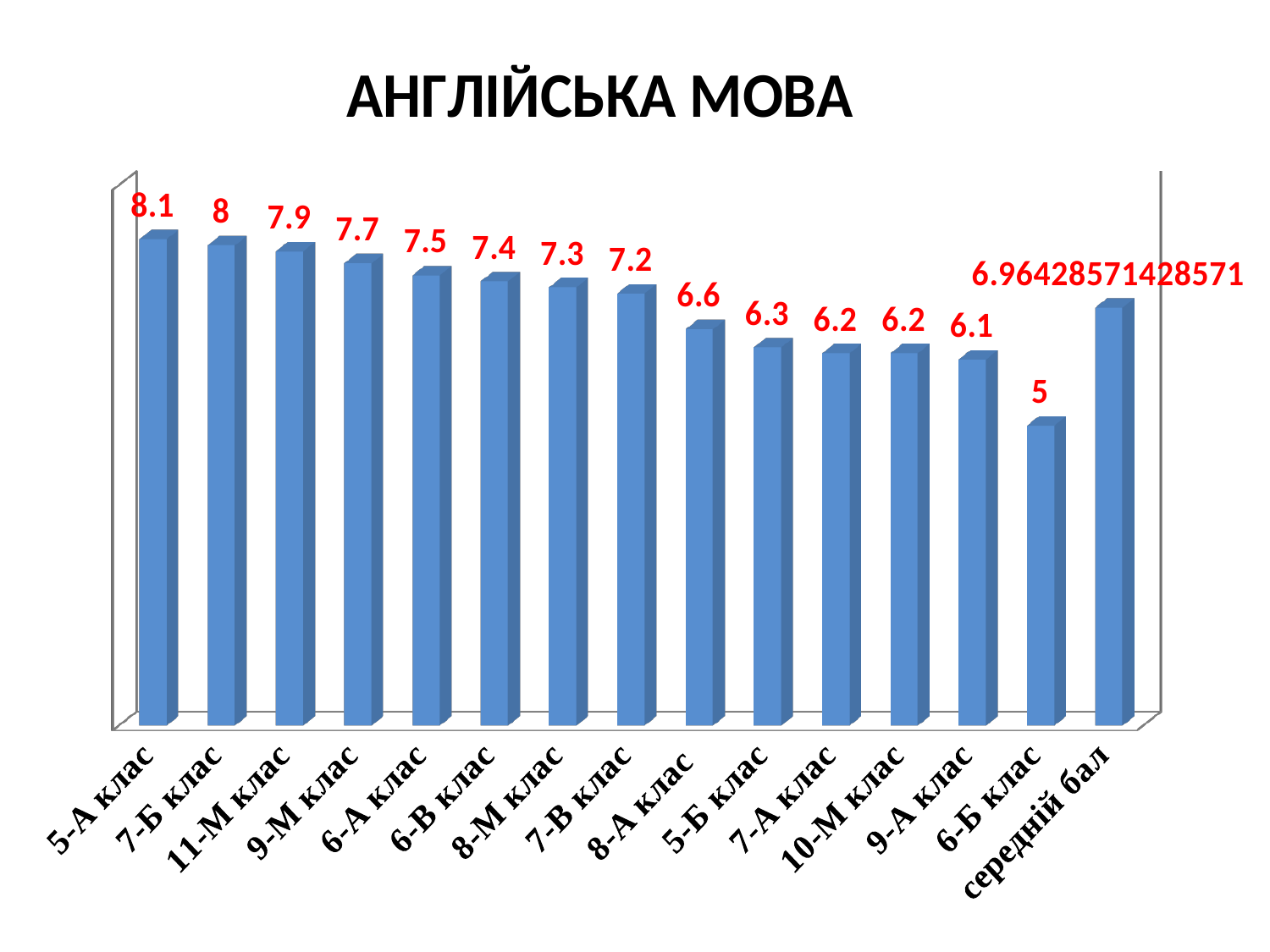
Which category has the lowest value? 6-Б клас What is the value for 6-Б клас? 5 What is the value shown for середній бал? 6.96428571428571 What is the difference between the values for 5-А клас and 6-Б клас? 3.1 What is the value for 8-А клас? 6.6 What kind of chart is shown? Bar chart What is the title of the chart? АНГЛІЙСЬКА МОВА Which is larger, the value for 9-М клас or the value for 5-Б клас? 9-М клас How many bars are plotted on the chart? 15 Which class has the highest value? 5-А клас What is the difference between the values for 7-Б клас and 8-А клас? 1.4 What is the value for 5-А клас? 8.1